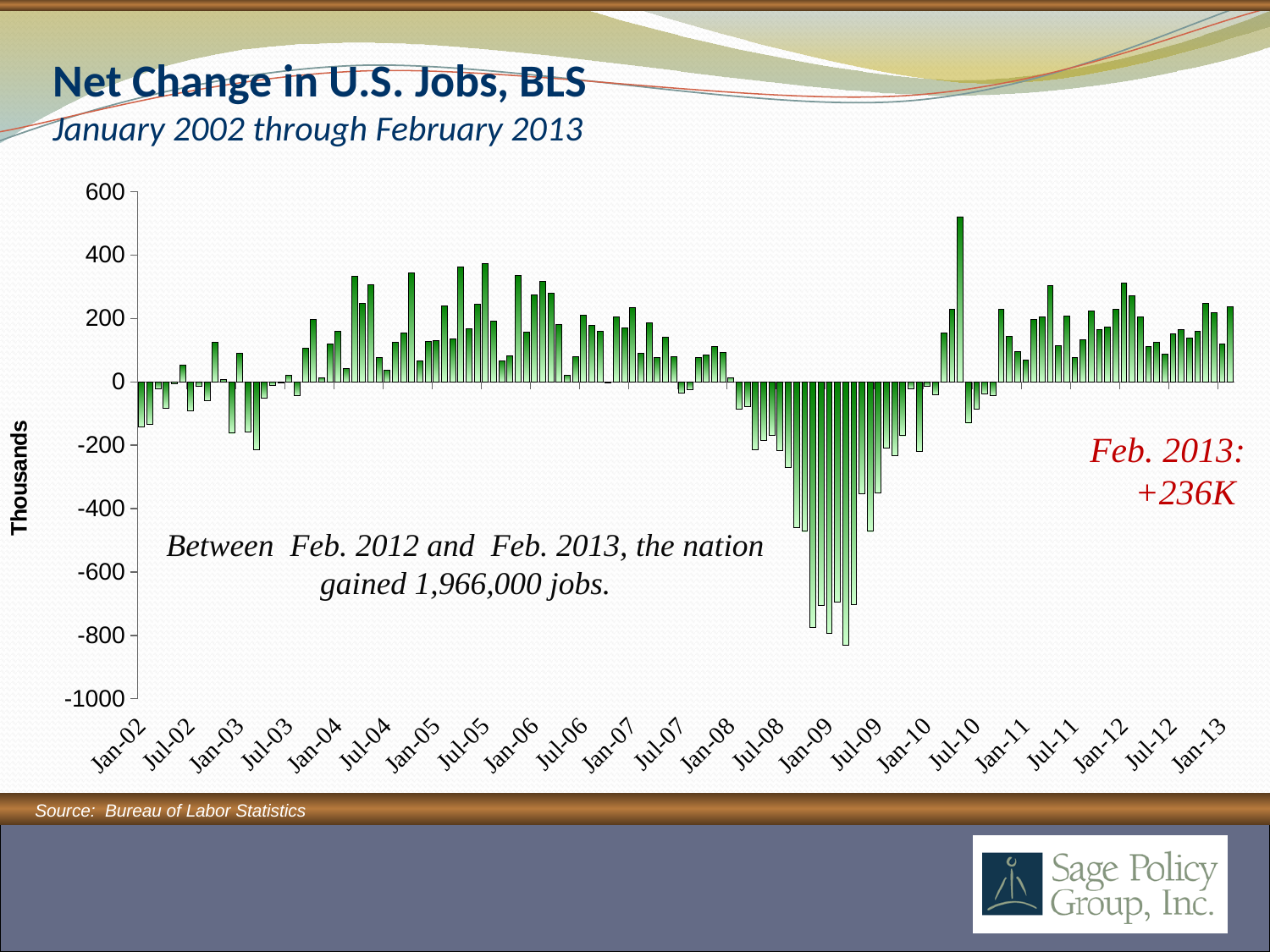
What unit does the y-axis label indicate the values are in? Thousands In which year does the lowest bar on the chart occur? 2009 What is the net change in U.S. jobs for Feb. 2013 according to the annotation on the chart? +236K In which year does the tallest bar on the chart occur? 2010 Is the value for Jan-09 greater or less than -600? less Which is larger, the value for Feb-13 or the value for Jan-09? Feb-13 Is the tallest bar on the chart greater or less than 400? greater Do the values rise or fall along the x axis from Jan-08 to Jan-09? fall Do the values rise or fall along the x axis from Jan-09 to Jan-10? rise Is the value for Jan-02 greater or less than 0? less How many tick labels are shown on the x axis? 23 What kind of chart is shown on the slide? bar chart